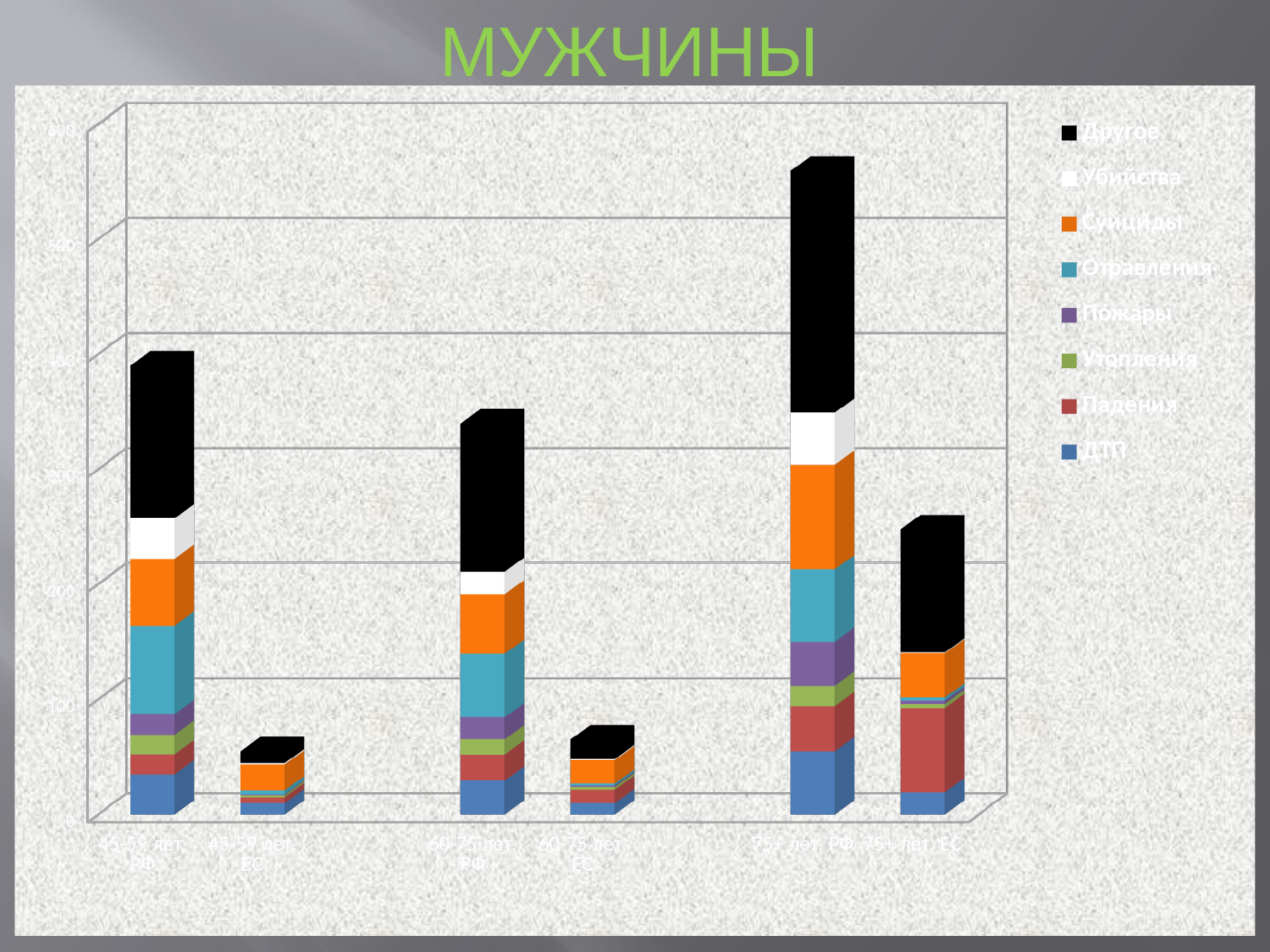
Which category has the tallest stacked bar? 75+ лет РФ What is the title of the slide above the chart? МУЖЧИНЫ Is the total value for 75+ лет РФ greater or less than 500? greater Is the total value for 45-59 лет ЕС greater or less than 100? less Is the total value for 60-75 лет РФ greater or less than 300? greater How many series does the legend list? 8 Which stacked bar is taller: 60-75 лет ЕС or 75+ лет ЕС? 75+ лет ЕС Which stacked bar is taller: 45-59 лет РФ or 60-75 лет РФ? 45-59 лет РФ How many categories are shown along the x axis? 6 Which series is shown in black in the legend? Другое What kind of chart is shown on the slide? stacked bar chart Which category has the shortest stacked bar? 45-59 лет ЕС